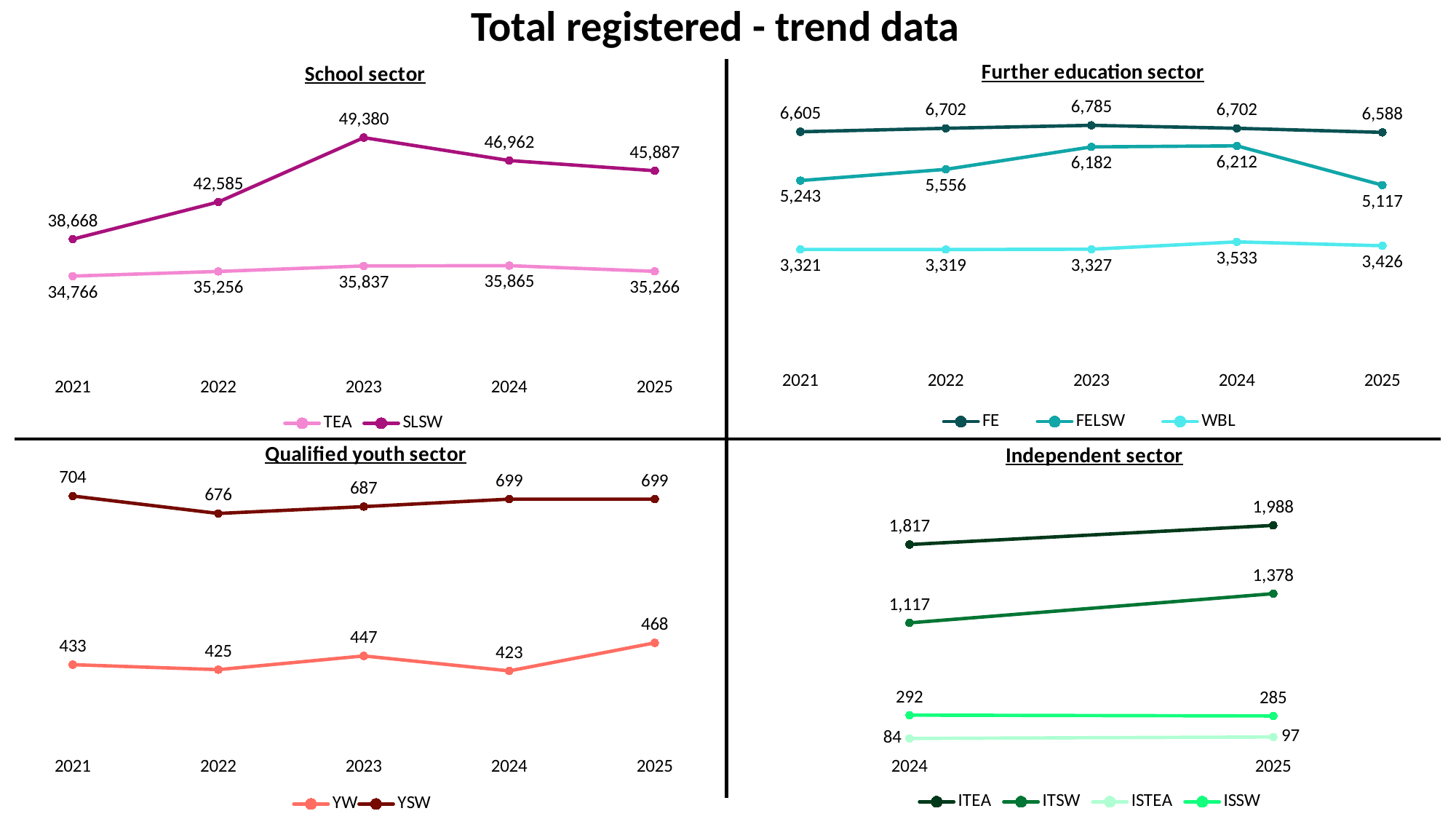
In the Independent sector chart, does the ISSW value rise or fall from 2024 to 2025? fall What kind of chart is the Qualified youth sector chart? line chart In the Further education sector chart, what is the FELSW value for 2025? 5,117 In the School sector chart, in which year is the TEA value highest? 2024 In the School sector chart, what is the difference between the SLSW and TEA values in 2025? 10,621 In the Independent sector chart, how many years are shown on the x axis? 2 In the Further education sector chart, how many series does the legend list? 3 In the School sector chart, what is the SLSW value for 2023? 49,380 In the Qualified youth sector chart, in which year is the YSW value lowest? 2022 In the Qualified youth sector chart, what is the YW value for 2025? 468 In the Further education sector chart, in which year is the WBL value highest? 2024 In the Independent sector chart, what is the ITSW value for 2024? 1,117